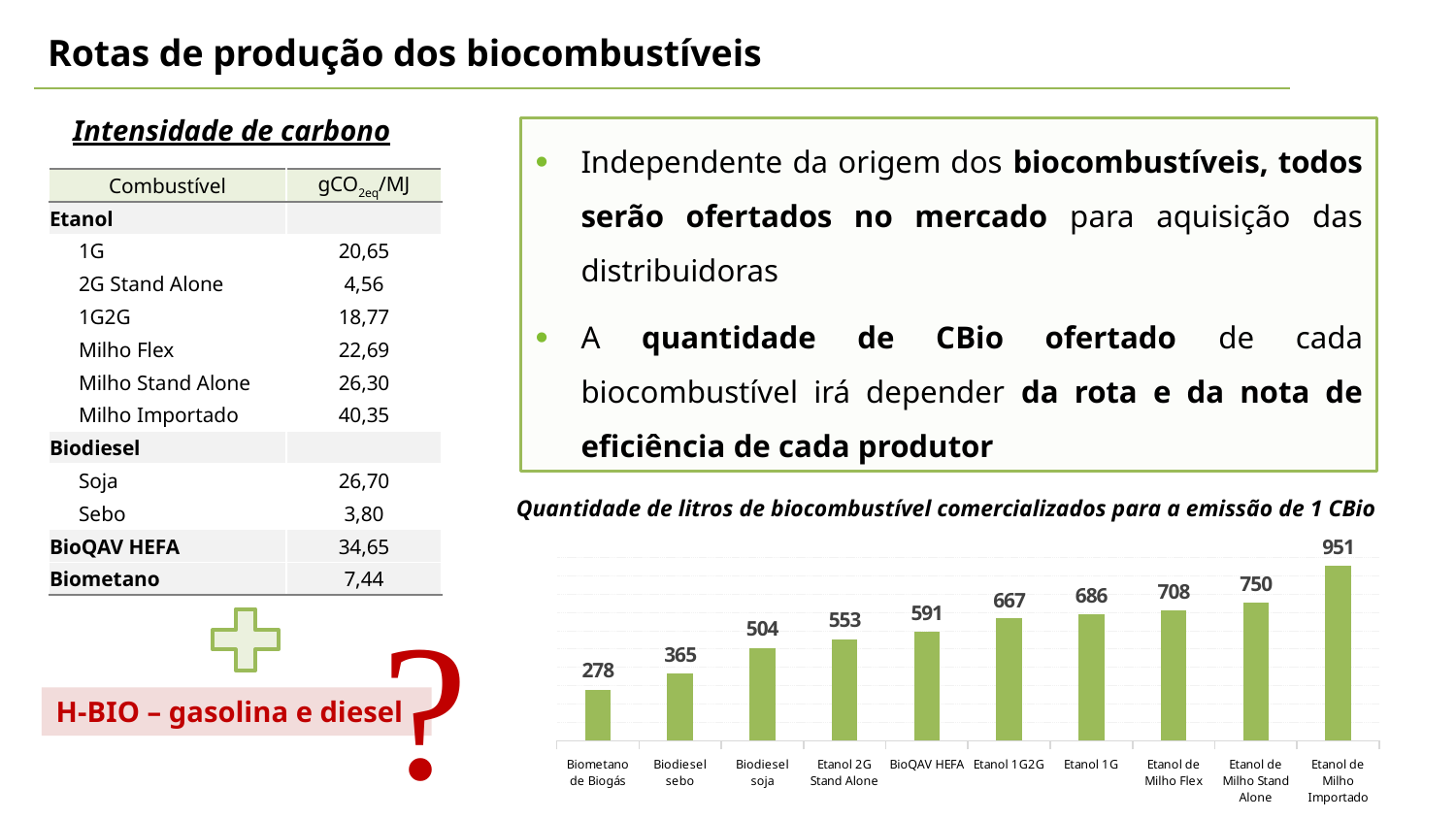
Which is larger, the value for Etanol 1G2G or the value for Etanol 2G Stand Alone? Etanol 1G2G Which category has the highest value in the chart? Etanol de Milho Importado What value does the chart show for BioQAV HEFA? 591 What is the difference between the values for Biodiesel soja and Biodiesel sebo? 139 What is the difference between the values for Etanol de Milho Importado and Etanol de Milho Stand Alone? 201 What kind of chart is shown on the slide? Bar chart What is the title of the chart? Quantidade de litros de biocombustível comercializados para a emissão de 1 CBio What value does the chart show for Etanol 1G? 686 Which category has the lowest value in the chart? Biometano de Biogás Do the values rise or fall from left to right along the x axis? Rise How many categories are shown in the chart? 10 What value does the chart show for Biodiesel soja? 504